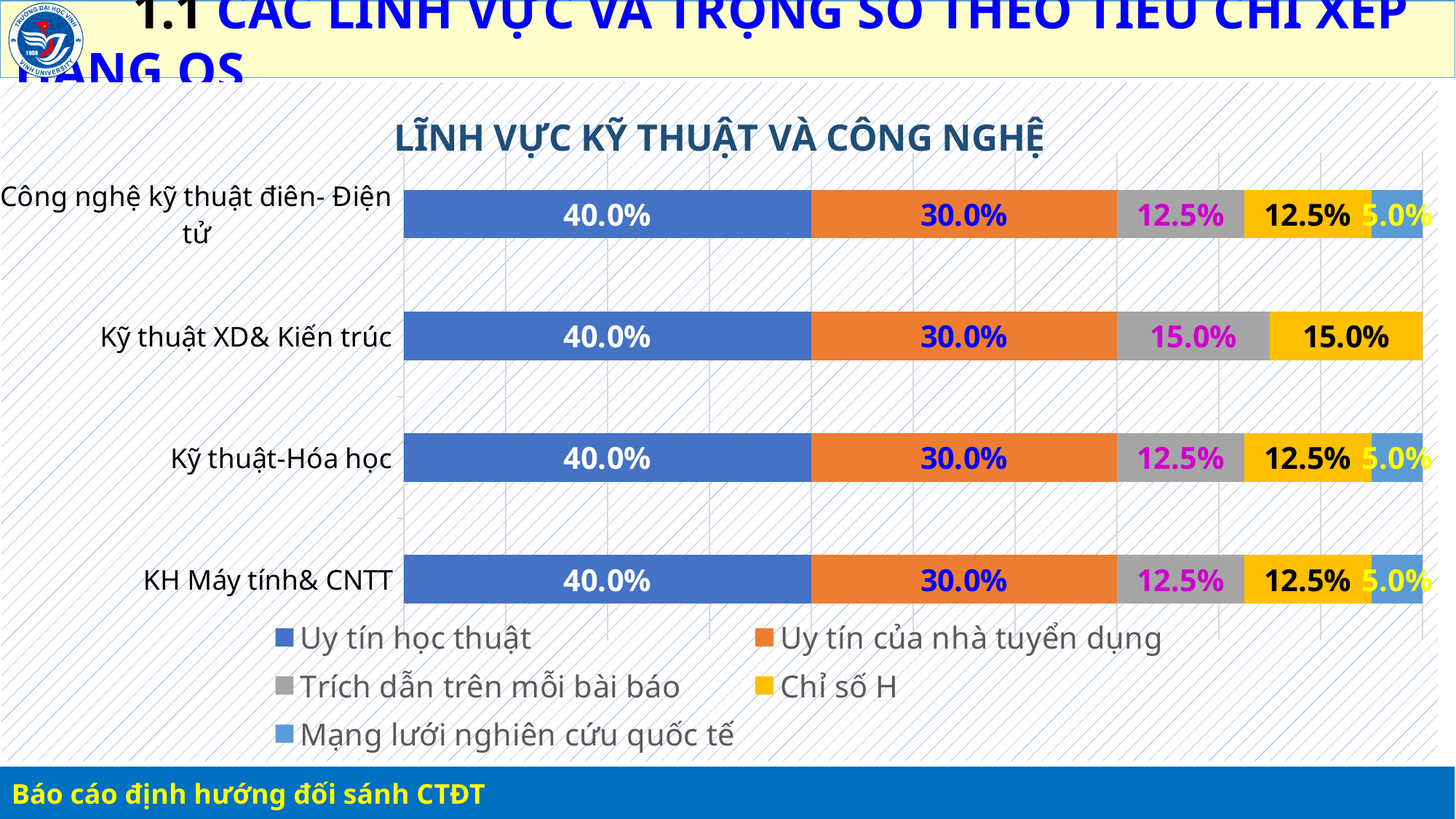
What is the value of Uy tín học thuật for Kỹ thuật-Hóa học? 40.0% What is the difference between Uy tín học thuật and Uy tín của nhà tuyển dụng for Kỹ thuật XD& Kiến trúc? 10.0% Which series has the lowest value for Kỹ thuật-Hóa học? Mạng lưới nghiên cứu quốc tế How many categories are shown on the chart? 4 What kind of chart is shown on the slide? Stacked bar chart Which series has the highest value for KH Máy tính& CNTT? Uy tín học thuật What is the value of Mạng lưới nghiên cứu quốc tế for KH Máy tính& CNTT? 5.0% What is the value of Chỉ số H for Kỹ thuật XD& Kiến trúc? 15.0% What is the value of Trích dẫn trên mỗi bài báo for Công nghệ kỹ thuật điện- Điện tử? 12.5% Which is larger for Công nghệ kỹ thuật điện- Điện tử: Uy tín của nhà tuyển dụng or Chỉ số H? Uy tín của nhà tuyển dụng How many series does the legend list? 5 What is the title of the chart? LĨNH VỰC KỸ THUẬT VÀ CÔNG NGHỆ